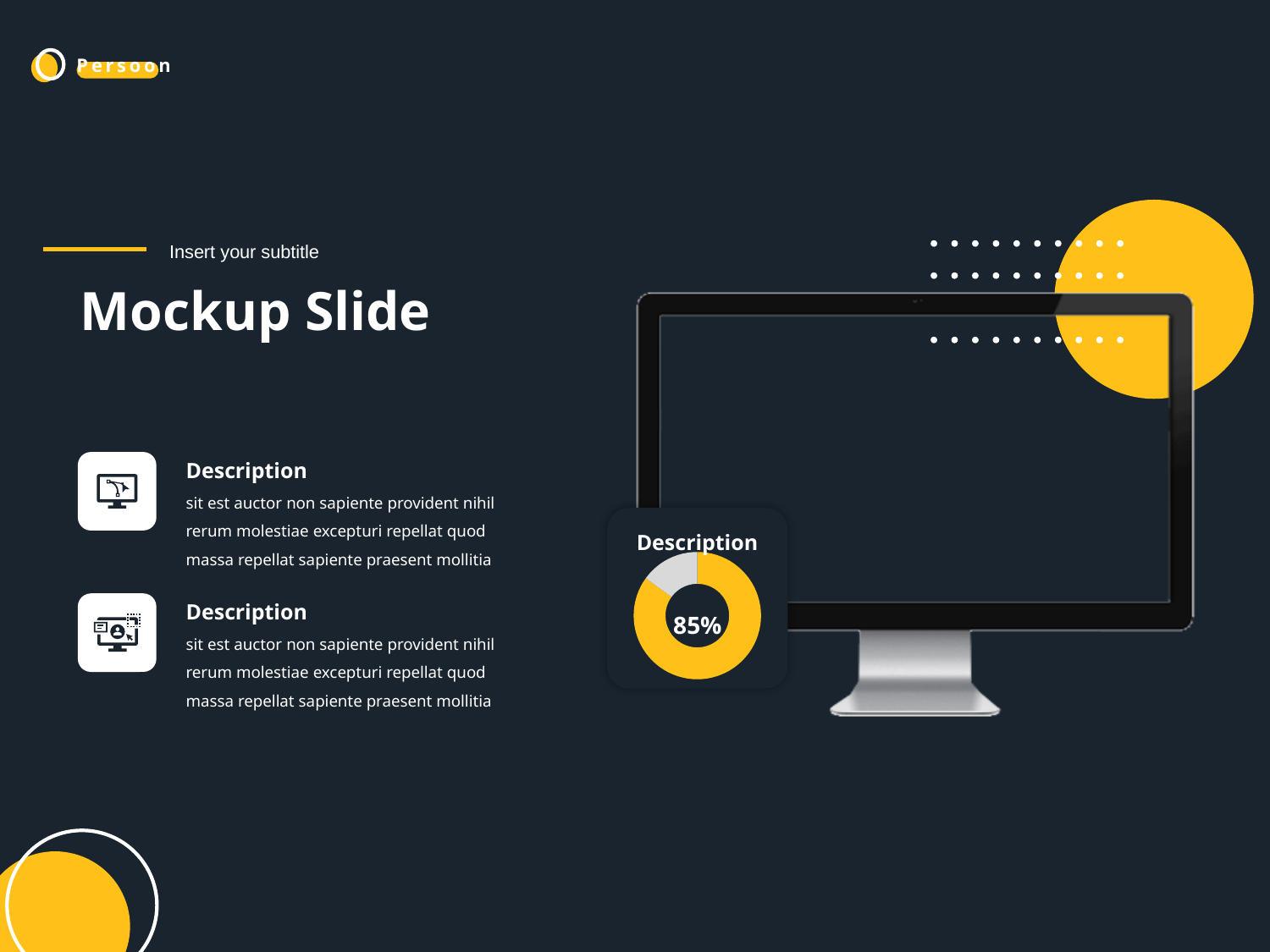
Which slice of the doughnut chart is larger, the yellow one or the grey one? The yellow one What share of the doughnut chart does the yellow slice represent? 85% What is the title shown above the doughnut chart? Description How many slices does the doughnut chart have? 2 What value is printed in the centre of the doughnut chart? 85% What colour is the largest slice of the doughnut chart? Yellow What kind of chart is shown on the slide? Doughnut chart